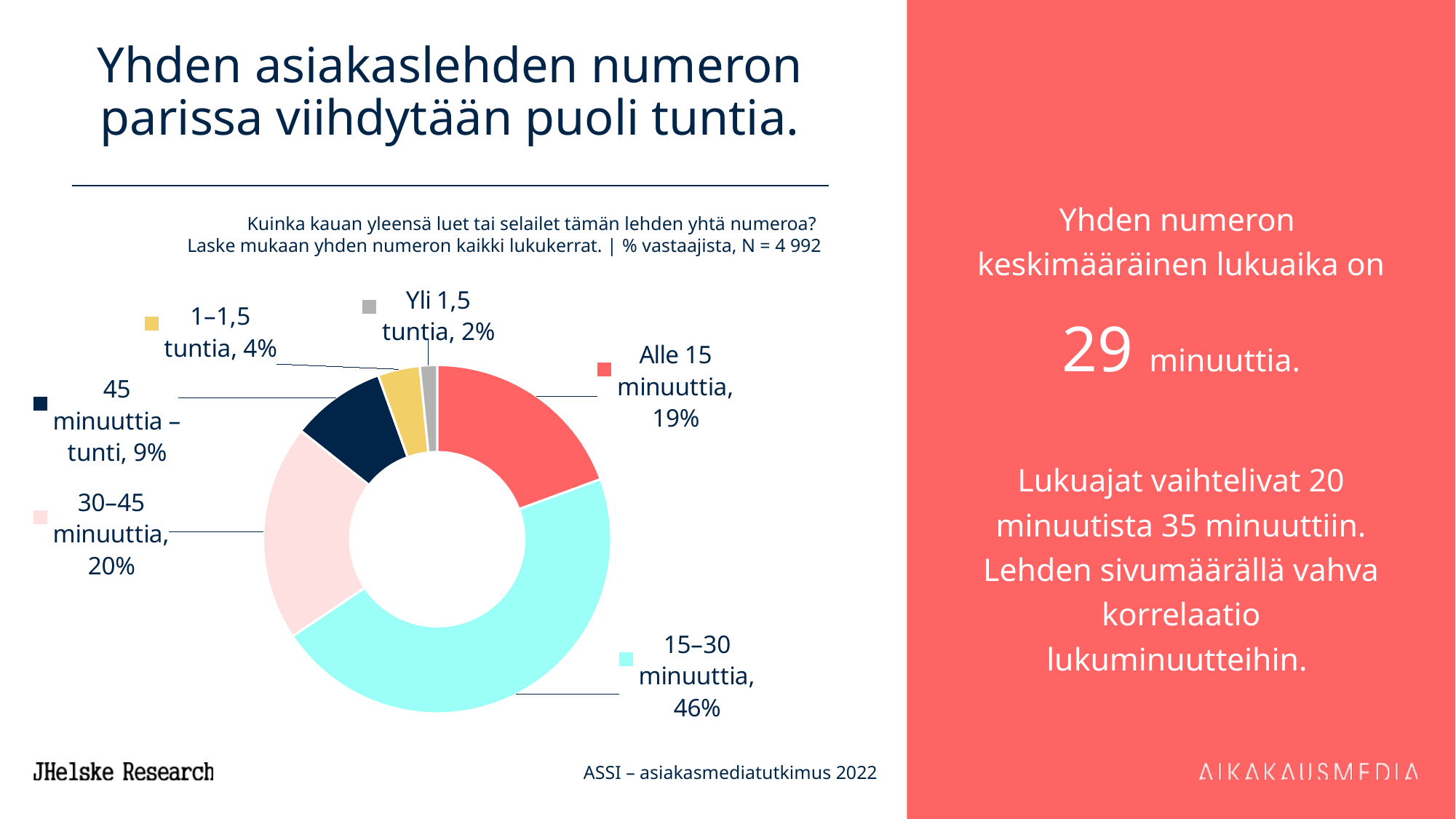
Which category has the largest share of the pie? 15–30 minuuttia What is the value for Yli 1,5 tuntia? 2% What is the value for 30–45 minuuttia? 20% Which category has the smallest share of the pie? Yli 1,5 tuntia What percentage of respondents chose Alle 15 minuuttia? 19% What percentage of respondents read for 45 minuuttia – tunti? 9% How many categories are shown in the chart? 6 What kind of chart is shown on the slide? Pie chart (doughnut) What is the sample size (N) stated in the chart subtitle? 4 992 What is the difference in percentage points between 15–30 minuuttia and 30–45 minuuttia? 26 Which is larger, the share for Alle 15 minuuttia or the share for 1–1,5 tuntia? Alle 15 minuuttia What share of respondents read one issue for 15–30 minuuttia? 46%